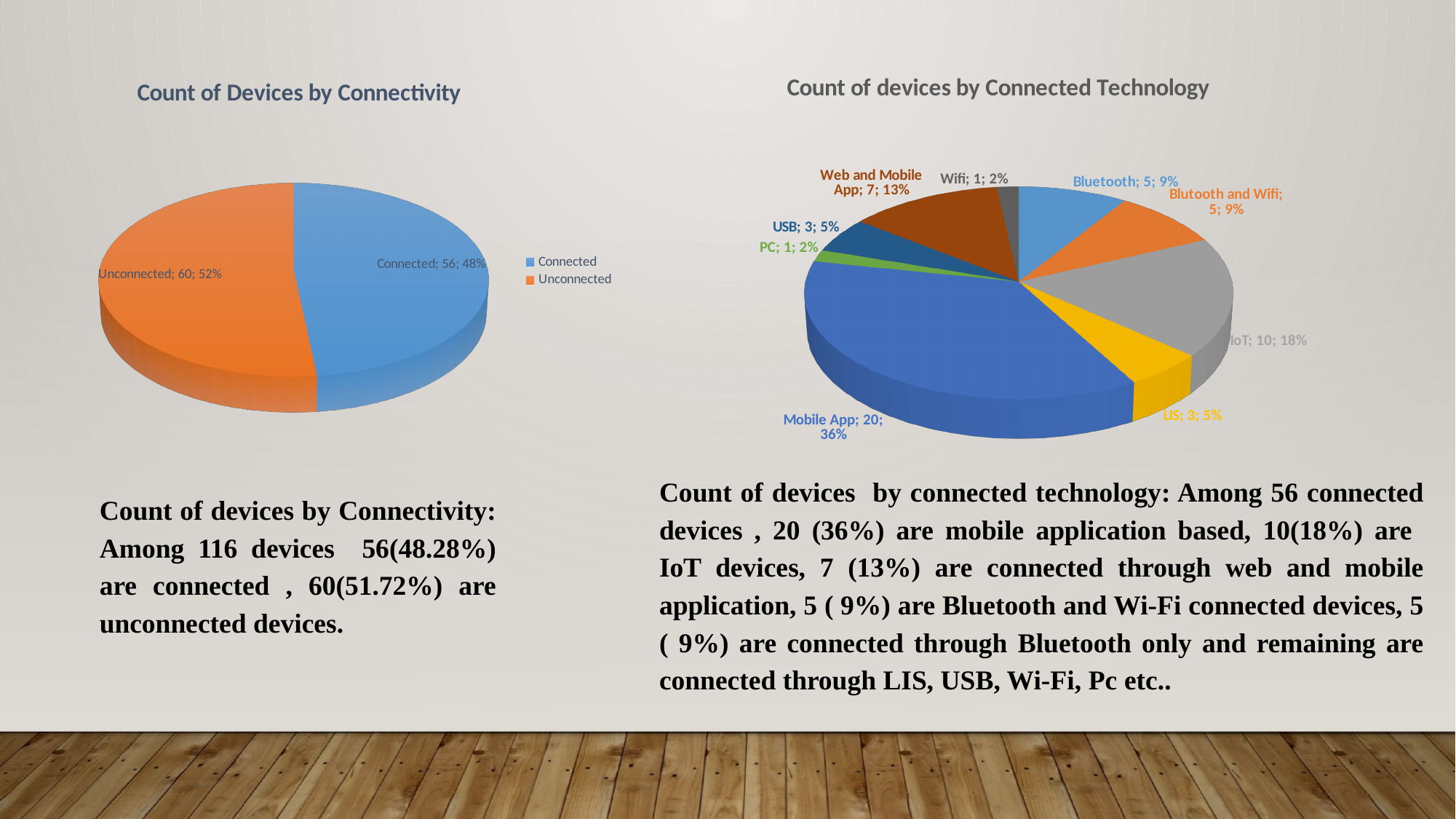
In the 'Count of devices by Connected Technology' chart, how many devices are Mobile App? 20 In the 'Count of Devices by Connectivity' chart, what share of the pie is Connected? 48% In the 'Count of Devices by Connectivity' chart, how many entries does the legend list? 2 In the 'Count of devices by Connected Technology' chart, what is the difference between the Mobile App and IoT counts? 10 In the 'Count of devices by Connected Technology' chart, which category has the largest slice? Mobile App In the 'Count of Devices by Connectivity' chart, how many devices are Unconnected? 60 In the 'Count of Devices by Connectivity' chart, what is the difference between the Unconnected and Connected counts? 4 In the 'Count of Devices by Connectivity' chart, which slice is larger, Connected or Unconnected? Unconnected In the 'Count of devices by Connected Technology' chart, which is larger, Web and Mobile App or USB? Web and Mobile App In the 'Count of Devices by Connectivity' chart, what kind of chart is shown? Pie chart In the 'Count of devices by Connected Technology' chart, how many categories are shown? 9 In the 'Count of devices by Connected Technology' chart, what share of the pie is IoT? 18%